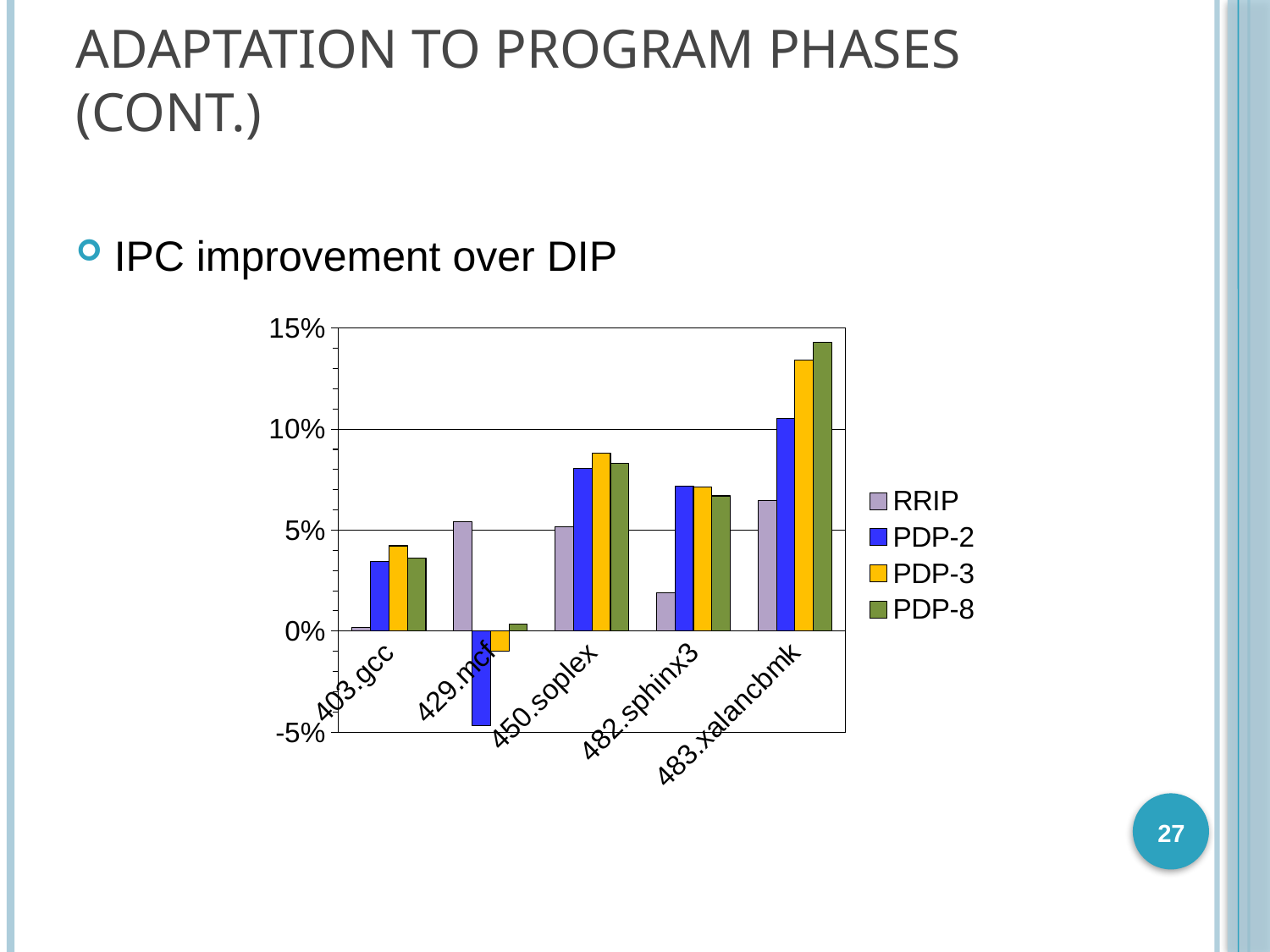
How many benchmark categories are shown on the x axis of the chart? 5 What kind of chart is shown on the slide? bar chart For 403.gcc, which is larger: the RRIP value or the PDP-3 value? PDP-3 What are the entries listed in the chart's legend? RRIP, PDP-2, PDP-3, PDP-8 For 429.mcf, which is larger: the RRIP value or the PDP-2 value? RRIP Which benchmark has the lowest PDP-2 value? 429.mcf Which benchmark has the highest PDP-8 value? 483.xalancbmk Is the PDP-2 value for 429.mcf greater or less than 0%? less Which series has the highest value for 483.xalancbmk? PDP-8 How many series does the chart's legend list? 4 Is the PDP-8 value for 483.xalancbmk greater or less than 10%? greater Is the RRIP value for 482.sphinx3 greater or less than 5%? less